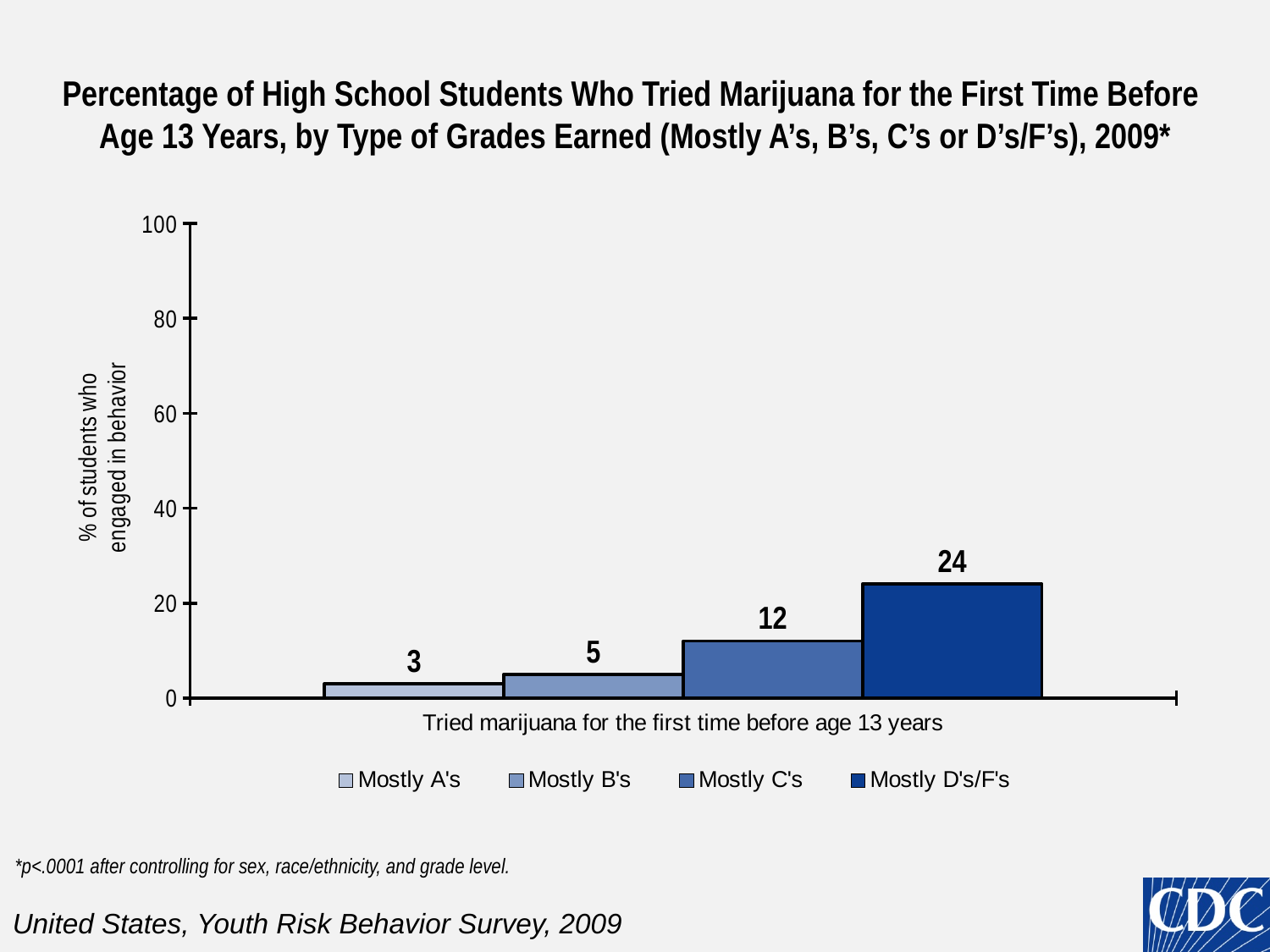
Which grade group has the highest percentage of students who tried marijuana before age 13? Mostly D's/F's What is the value shown for Mostly C's? 12 Which grade group has the lowest percentage? Mostly A's Which is larger, the value for Mostly B's or the value for Mostly C's? Mostly C's What is the label on the y axis? % of students who engaged in behavior What is the value shown for Mostly D's/F's? 24 What percentage of students with Mostly A's tried marijuana for the first time before age 13 years? 3 What kind of chart is shown on the slide? Bar chart How many series does the legend list? 4 What is the difference between the values for Mostly D's/F's and Mostly C's? 12 What is the value shown for Mostly B's? 5 Is the value for Mostly D's/F's greater or less than 20? greater